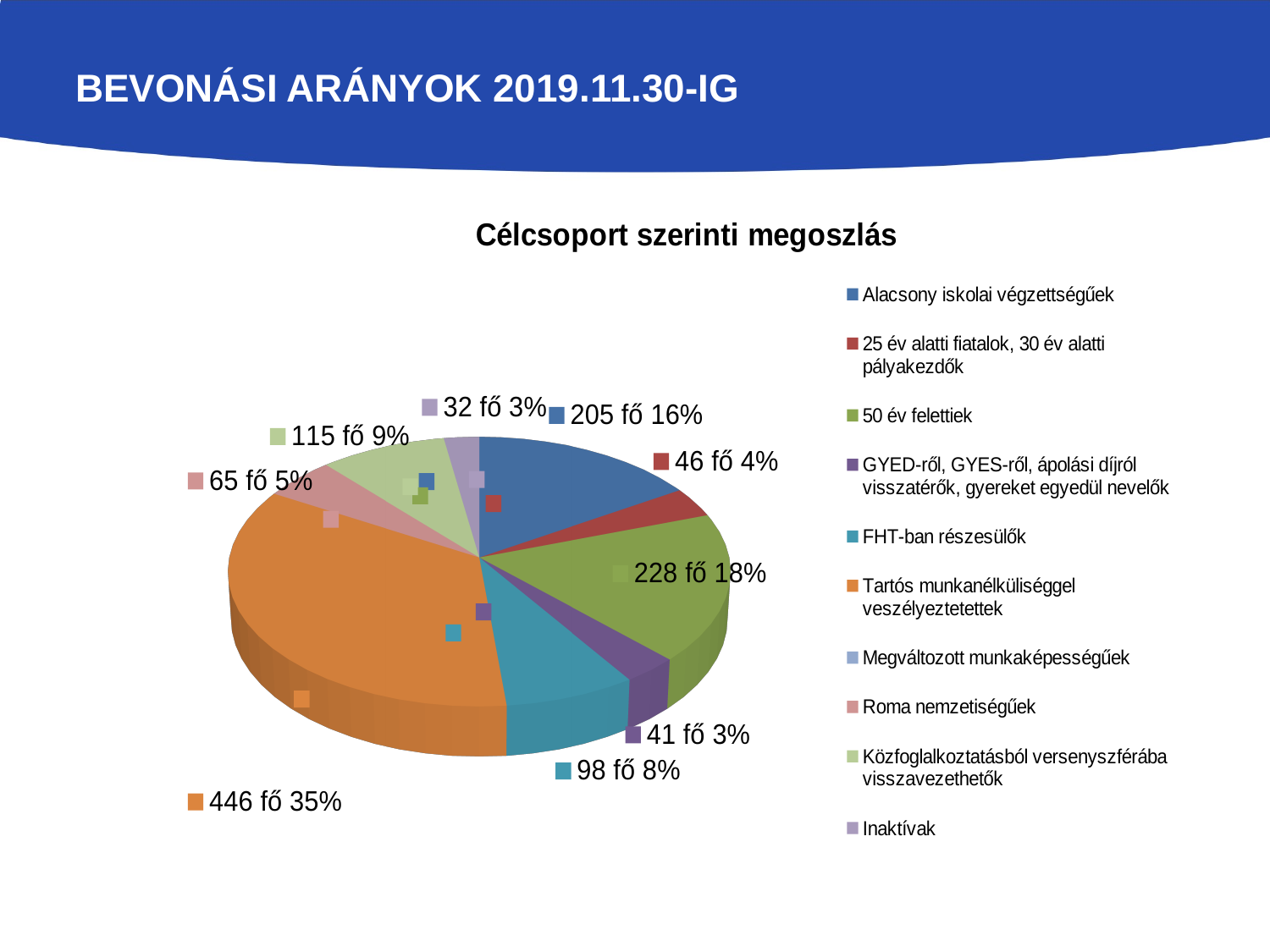
What type of chart is shown on the slide? pie chart What share of the pie does Tartós munkanélküliséggel veszélyeztetettek represent? 35% How many entries does the chart legend list? 10 Which category has the largest slice of the pie? Tartós munkanélküliséggel veszélyeztetettek What value is shown for Roma nemzetiségűek? 65 fő 5% What is the difference in headcount between 50 év felettiek (228 fő) and Alacsony iskolai végzettségűek (205 fő)? 23 fő What is the title of the chart? Célcsoport szerinti megoszlás What value is shown for Közfoglalkoztatásból versenyszférába visszavezethetők? 115 fő 9% What value is shown for FHT-ban részesülők? 98 fő 8% What value is shown for 50 év felettiek? 228 fő 18% What value is shown for Alacsony iskolai végzettségűek? 205 fő 16% Which is larger: the value for 50 év felettiek or for Alacsony iskolai végzettségűek? 50 év felettiek